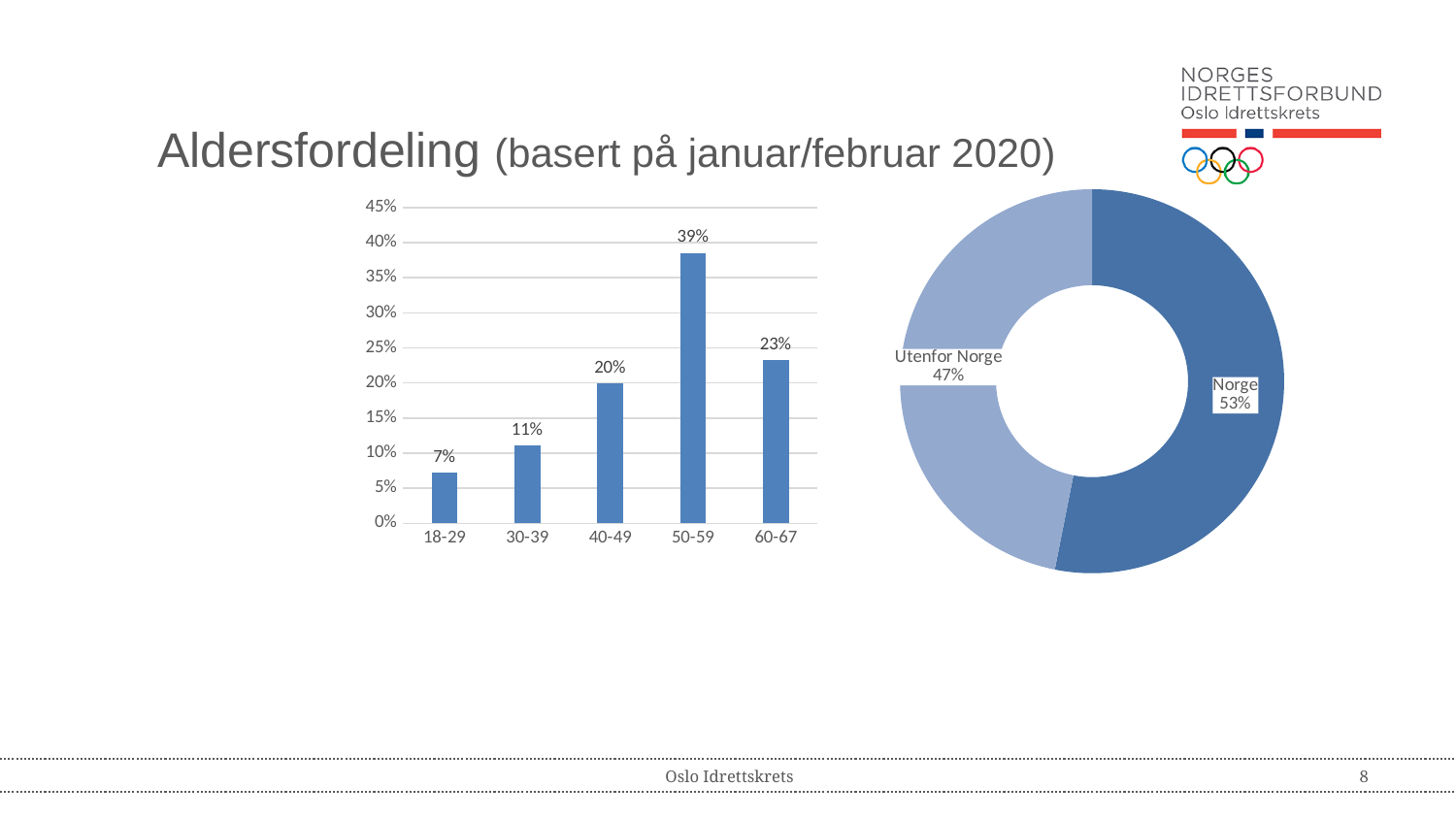
What kind of chart is shown on the left of the slide? Bar chart In the bar chart on the left, what is the value for the 18-29 age group? 7% In the bar chart on the left, which age group has the highest value? 50-59 In the doughnut chart on the right, what share is labelled Utenfor Norge? 47% In the bar chart on the left, which is larger: the value for 40-49 or the value for 30-39? 40-49 What is the title of the slide? Aldersfordeling (basert på januar/februar 2020) In the bar chart on the left, what is the value for the 50-59 age group? 39% In the bar chart on the left, what is the difference between the values for 50-59 and 60-67? 16% In the bar chart on the left, how many age groups are shown on the x axis? 5 In the bar chart on the left, which age group has the lowest value? 18-29 In the doughnut chart on the right, what share is labelled Norge? 53% In the doughnut chart on the right, which segment is larger: Norge or Utenfor Norge? Norge